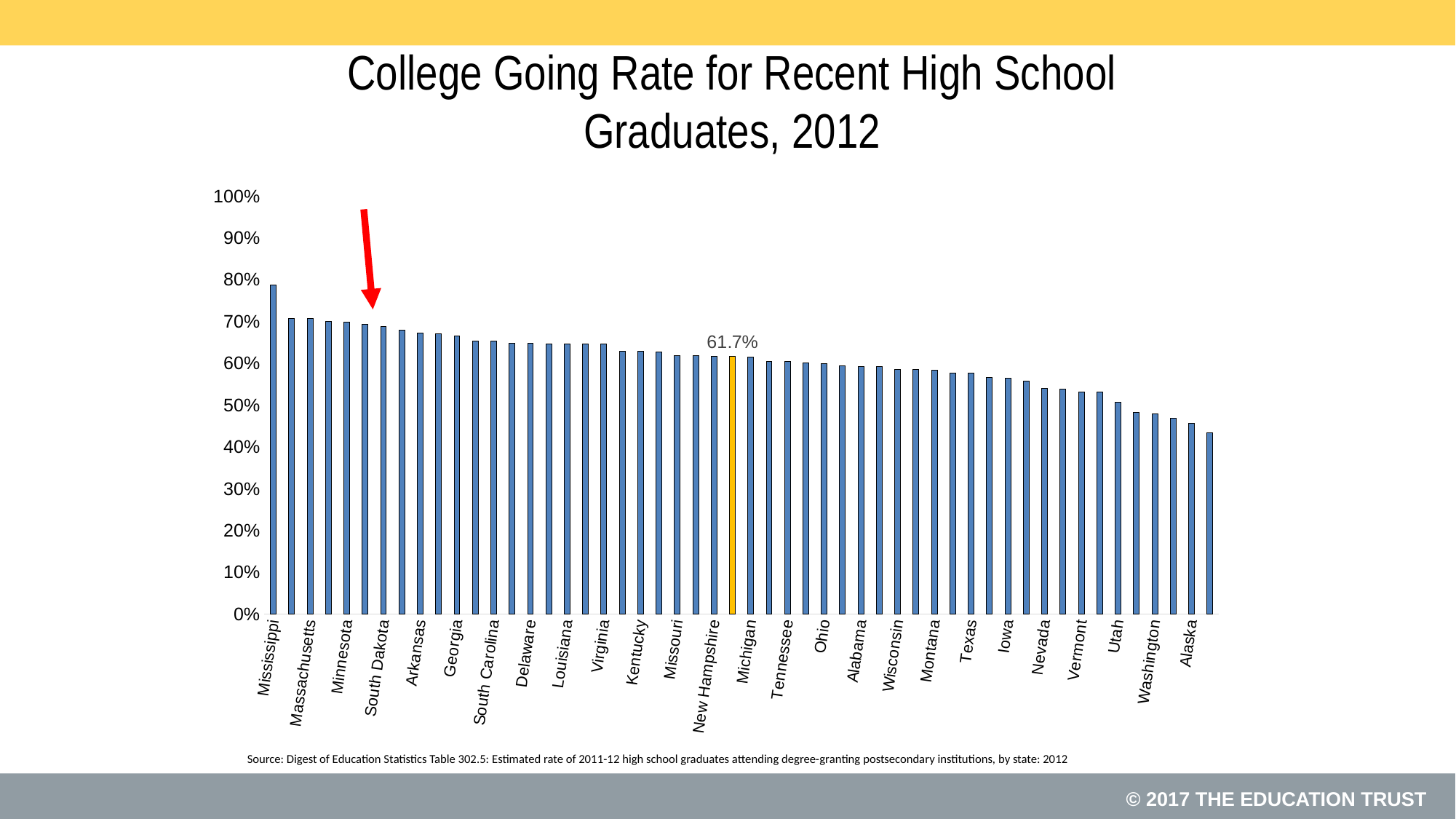
Is the value for Mississippi greater or less than 70%? greater Is the value for Alaska greater or less than 50%? less What kind of chart is shown on the slide? bar chart What value is printed on the highlighted yellow bar? 61.7% Which has a higher college going rate, Mississippi or Alaska? Mississippi Is the value for Nevada greater or less than 60%? less Do the values rise or fall moving from left to right along the x axis? fall Which state has the highest college going rate? Mississippi What is the title of the chart? College Going Rate for Recent High School Graduates, 2012 Which has a higher college going rate, Massachusetts or Washington? Massachusetts